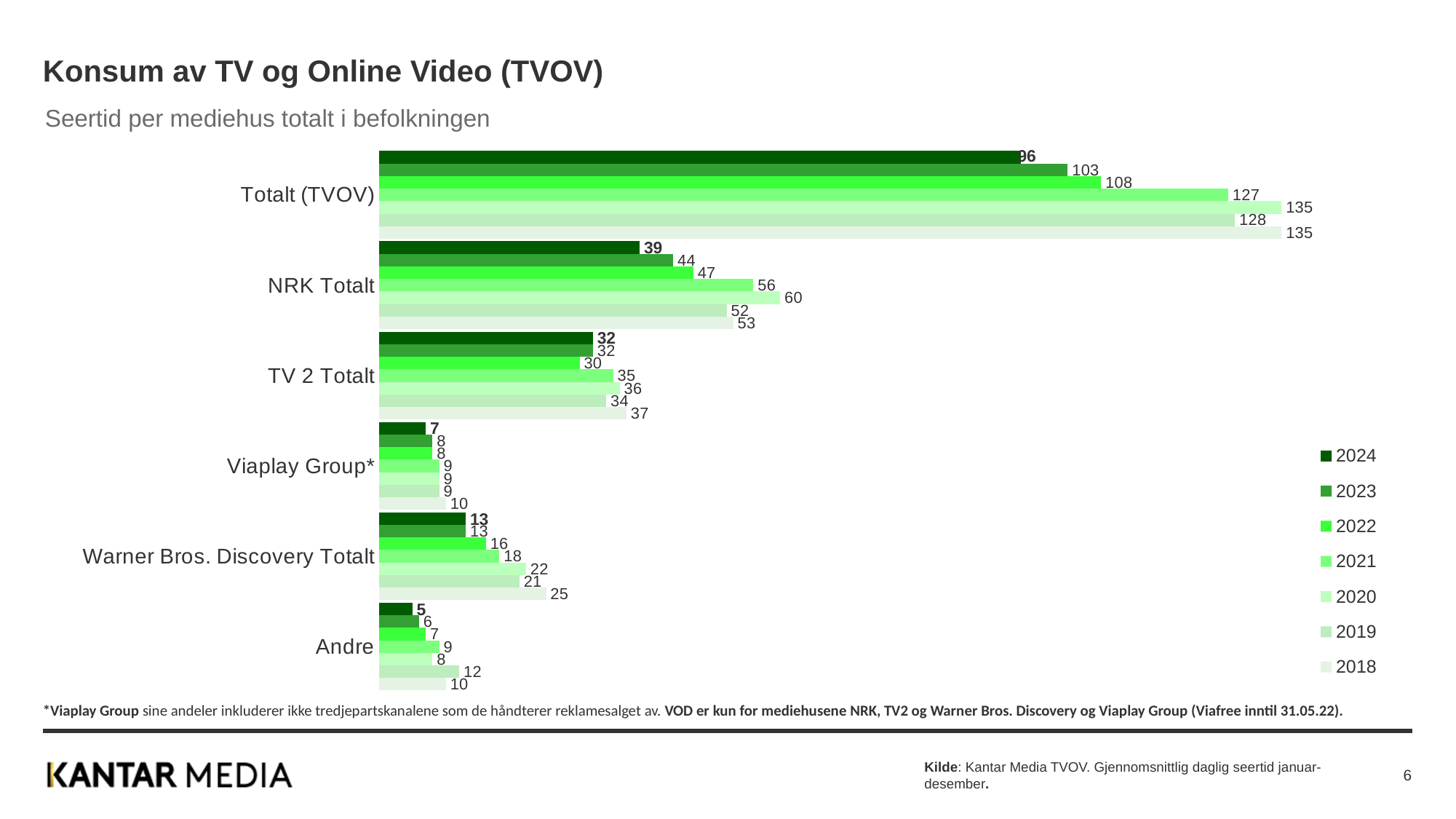
What is the value for NRK Totalt in 2024? 39 What is the value for TV 2 Totalt in 2022? 30 Which is larger in 2024: Viaplay Group* or Warner Bros. Discovery Totalt? Warner Bros. Discovery Totalt What is the value for Andre in 2019? 12 What kind of chart is shown on the slide? bar chart How many series does the legend list? 7 How many categories are shown on the chart? 6 Which category has the lowest value in 2024? Andre Did the value for NRK Totalt rise or fall from 2022 to 2024? fall Which category has the highest value in 2024? Totalt (TVOV) What is the difference between the NRK Totalt values for 2020 and 2024? 21 What is the value for Warner Bros. Discovery Totalt in 2018? 25